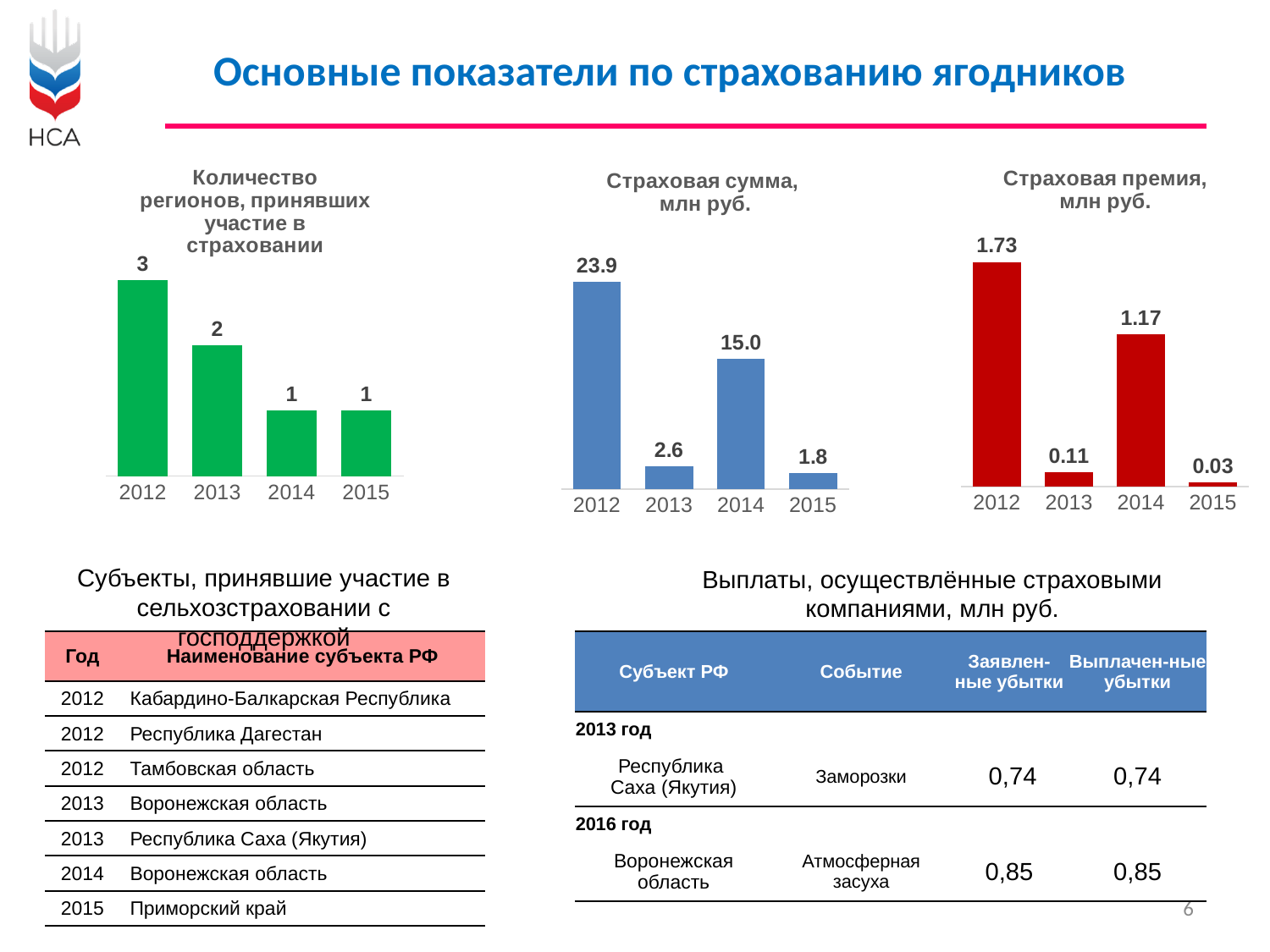
In the chart 'Страховая сумма, млн руб.', what is the difference between the values for 2012 and 2014? 8.9 In the chart 'Количество регионов, принявших участие в страховании', do the values rise or fall from 2012 to 2014? fall In the chart 'Страховая премия, млн руб.', which is larger, the value for 2013 or the value for 2014? 2014 In the chart 'Страховая сумма, млн руб.', which year has the highest value? 2012 In the chart 'Страховая премия, млн руб.', what is the value for 2015? 0.03 What colour are the bars in the chart 'Страховая премия, млн руб.'? red In the chart 'Количество регионов, принявших участие в страховании', what is the value for 2012? 3 In the chart 'Страховая премия, млн руб.', which year has the lowest value? 2015 How many years are shown in the chart 'Количество регионов, принявших участие в страховании'? 4 In the chart 'Страховая сумма, млн руб.', what is the value for 2014? 15.0 In the chart 'Страховая премия, млн руб.', what is the difference between the values for 2012 and 2013? 1.62 What kind of chart is 'Страховая сумма, млн руб.'? bar chart